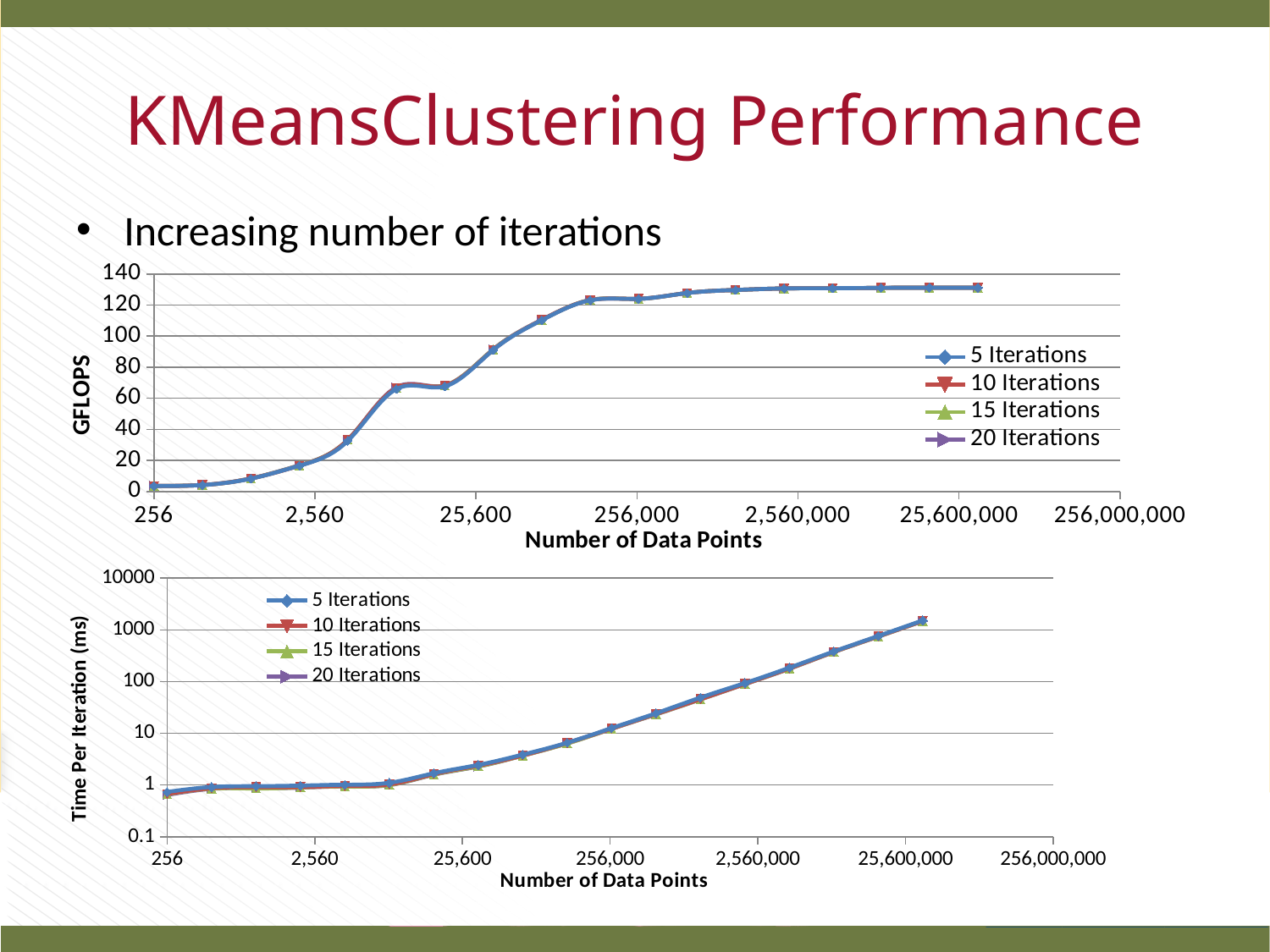
How many series does the legend of the bottom chart list? 4 In the top chart, do the GFLOPS values rise or fall as the number of data points increases? rise How many series does the legend of the top chart list? 4 In the top chart, is the GFLOPS value at 256,000 data points greater or less than 100? greater What is the x-axis title of the top chart? Number of Data Points In the bottom chart, does the time per iteration rise or fall as the number of data points increases? rise What kind of chart is the top chart (GFLOPS vs Number of Data Points)? line chart What is the y-axis title of the bottom chart? Time Per Iteration (ms) In the bottom chart, is the time per iteration at 256 data points greater or less than 10 ms? less In the top chart, is the GFLOPS value at 256 data points greater or less than 20? less What kind of chart is the bottom chart (Time Per Iteration vs Number of Data Points)? line chart